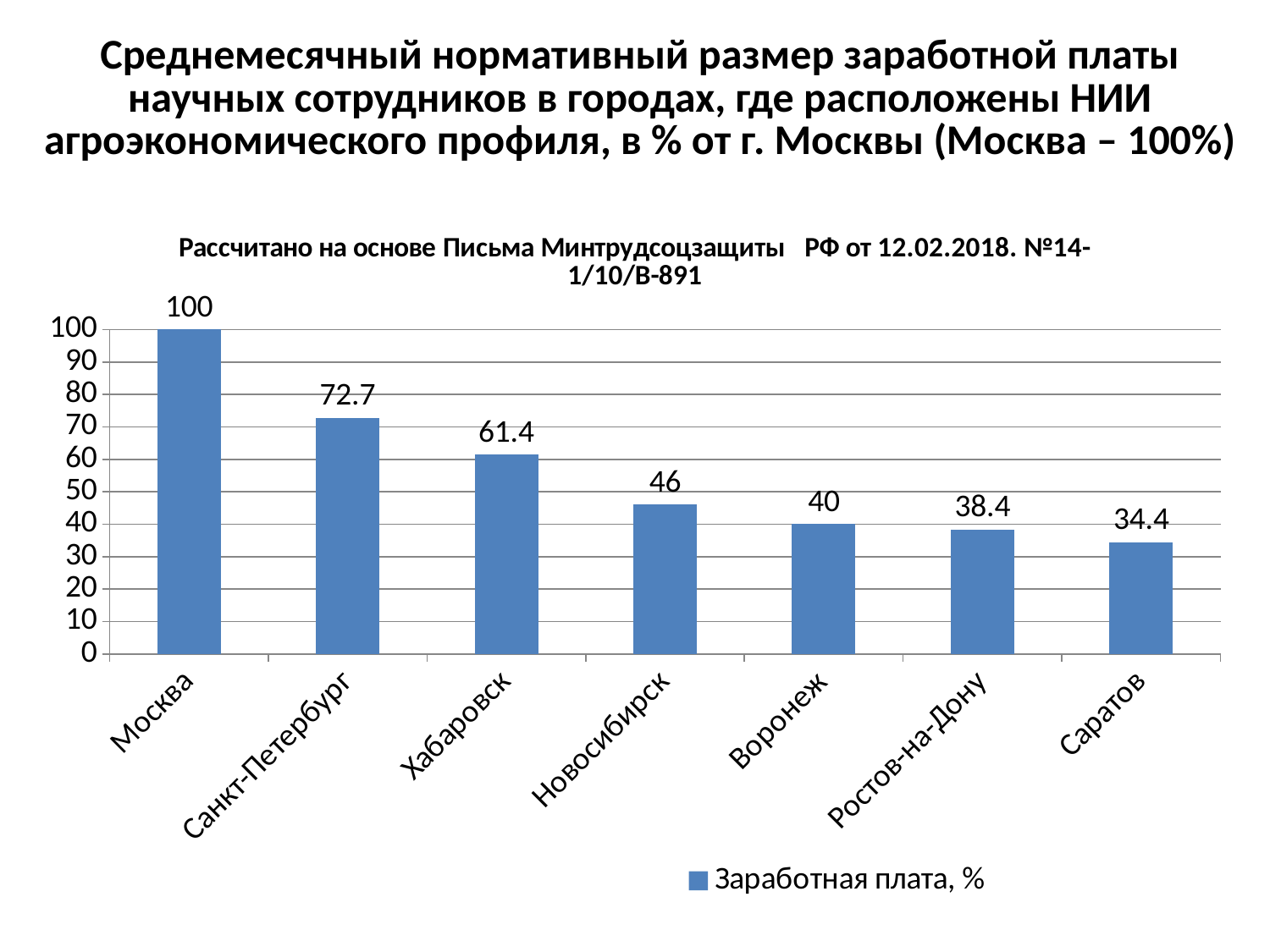
Which city has the lowest value? Саратов Which city has the highest value? Москва Which is larger, the value for Хабаровск or the value for Новосибирск? Хабаровск What kind of chart is this? bar chart What is the difference between the values for Новосибирск and Воронеж? 6 How many series does the legend list? 1 How many cities are shown on the chart? 7 What is the value for Ростов-на-Дону? 38.4 What is the value for Санкт-Петербург? 72.7 What is the legend entry of the chart? Заработная плата, % What is the difference between the values for Москва and Санкт-Петербург? 27.3 What is the value for Хабаровск? 61.4